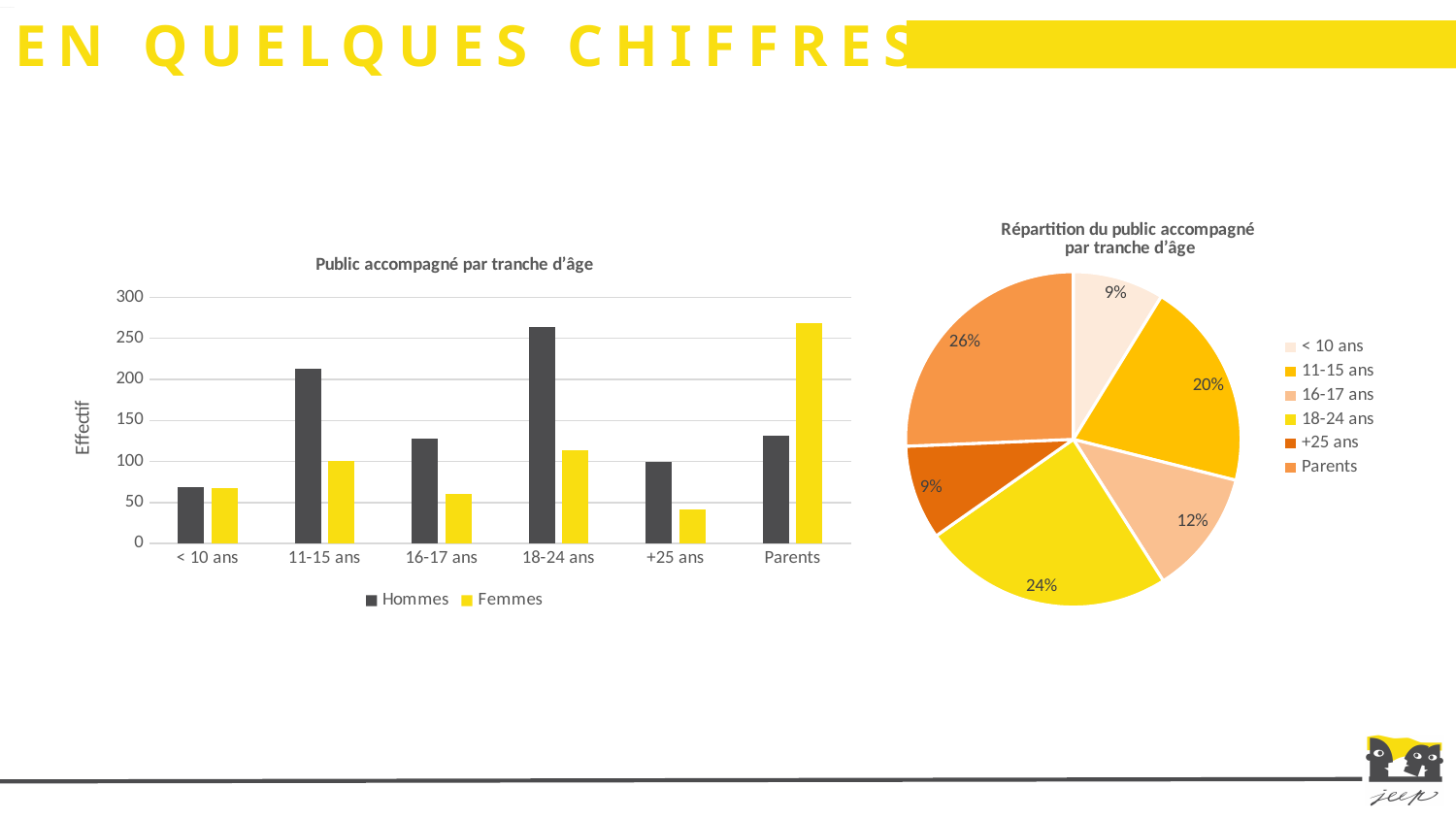
In the chart titled "Répartition du public accompagné par tranche d'âge", what share does 18-24 ans have? 24% In the chart titled "Répartition du public accompagné par tranche d'âge", what is the difference between the 11-15 ans share and the 16-17 ans share? 8% In the chart titled "Public accompagné par tranche d'âge", how many age categories are shown on the x axis? 6 In the chart titled "Répartition du public accompagné par tranche d'âge", what kind of chart is it? pie chart In the chart titled "Public accompagné par tranche d'âge", what kind of chart is it? bar chart In the chart titled "Répartition du public accompagné par tranche d'âge", which category has the largest share? Parents In the chart titled "Public accompagné par tranche d'âge", is the Hommes value for 18-24 ans greater or less than 250? greater In the chart titled "Public accompagné par tranche d'âge", how many series does the legend list? 2 In the chart titled "Public accompagné par tranche d'âge", which is larger for Parents, Hommes or Femmes? Femmes In the chart titled "Public accompagné par tranche d'âge", which category has the highest Hommes value? 18-24 ans In the chart titled "Répartition du public accompagné par tranche d'âge", what share does Parents have? 26% In the chart titled "Public accompagné par tranche d'âge", is the Femmes value for +25 ans greater or less than 50? less